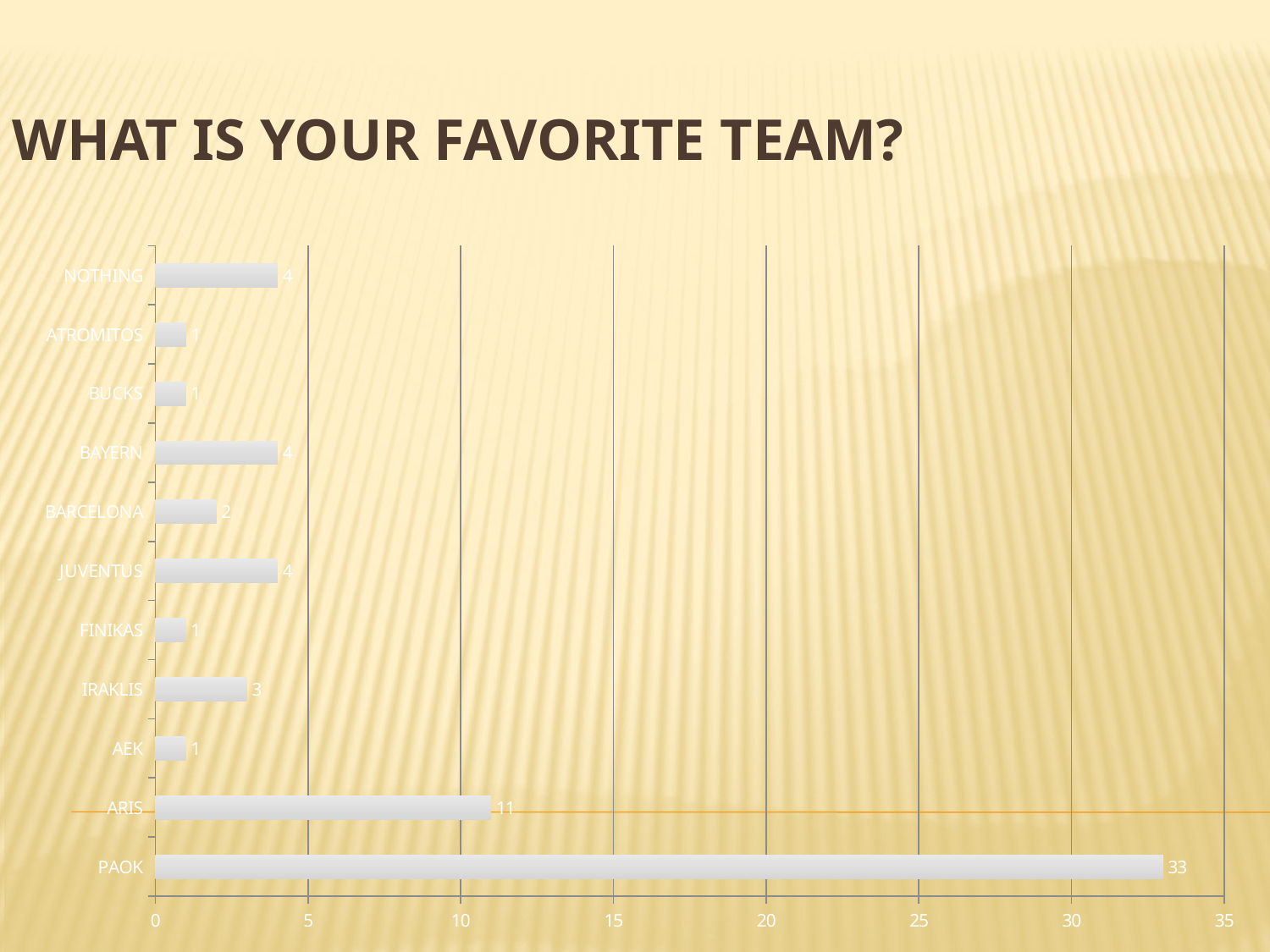
How many categories are shown on the chart? 11 What is the difference between the values for PAOK and ARIS? 22 Which category has the highest value? PAOK What is the value for PAOK? 33 What is the value for IRAKLIS? 3 Which is larger, the value for JUVENTUS or the value for IRAKLIS? JUVENTUS Is the value for PAOK greater or less than 30? greater What is the difference between the values for NOTHING and ATROMITOS? 3 What is the title of the slide? WHAT IS YOUR FAVORITE TEAM? What kind of chart is shown on the slide? bar chart What is the value for ARIS? 11 What is the value for BARCELONA? 2